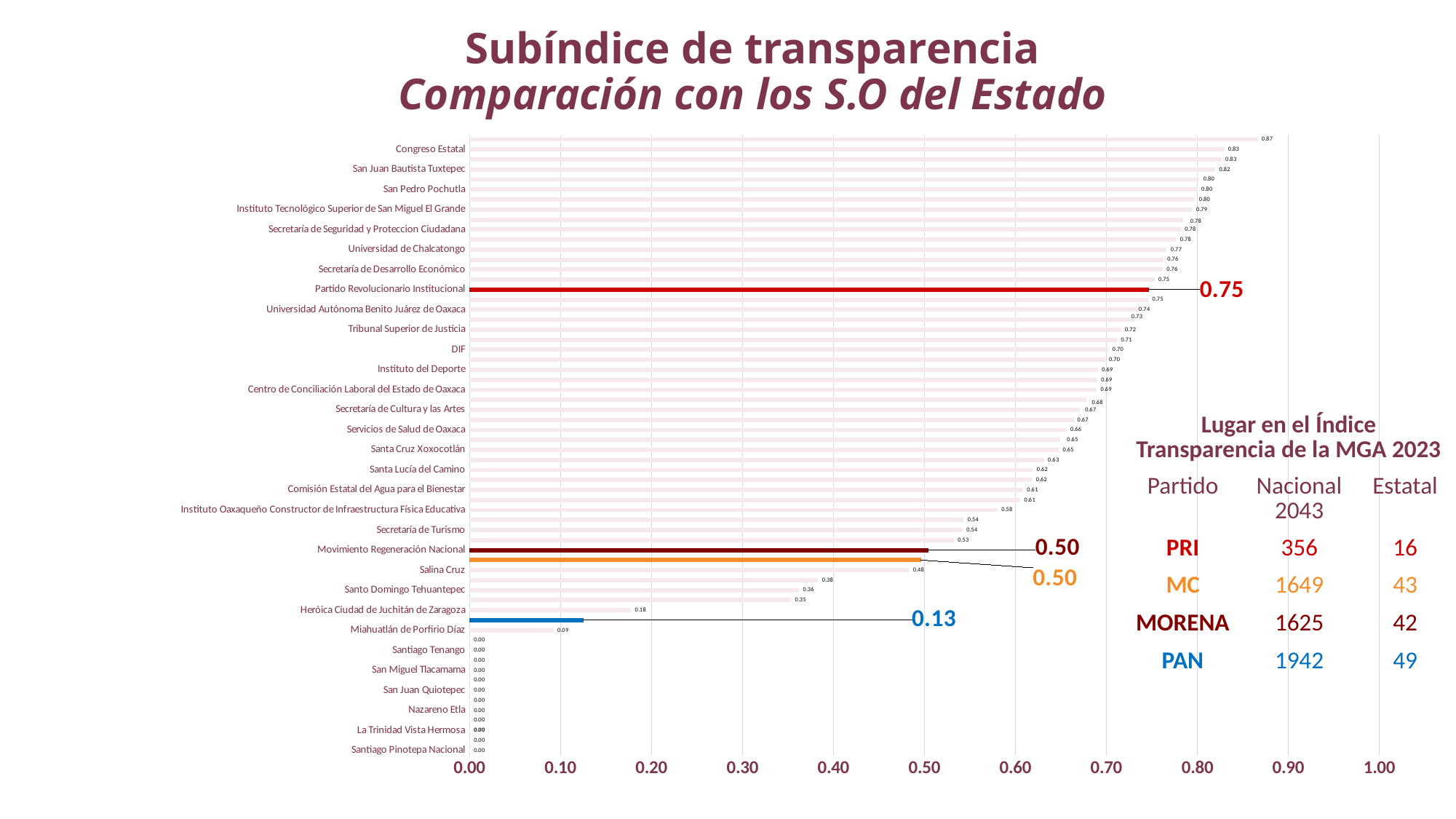
What is the difference between the values for Partido Revolucionario Institucional and Movimiento Regeneración Nacional? 0.25 What is the value for Santo Domingo Tehuantepec? 0.36 What is the value for Salina Cruz? 0.48 What colour is the bar for Partido Revolucionario Institucional? Red What is the value for Movimiento Regeneración Nacional? 0.50 Is the value for Heróica Ciudad de Juchitán de Zaragoza greater or less than 0.20? less What is the value for Partido Revolucionario Institucional? 0.75 What is the value for Congreso Estatal? 0.83 What kind of chart is shown on the slide? Bar chart Do the bar values increase or decrease from the top of the chart to the bottom? Decrease What is the value for Secretaría de Turismo? 0.54 Which has a higher value, Santa Cruz Xoxocotlán or Santa Lucía del Camino? Santa Cruz Xoxocotlán